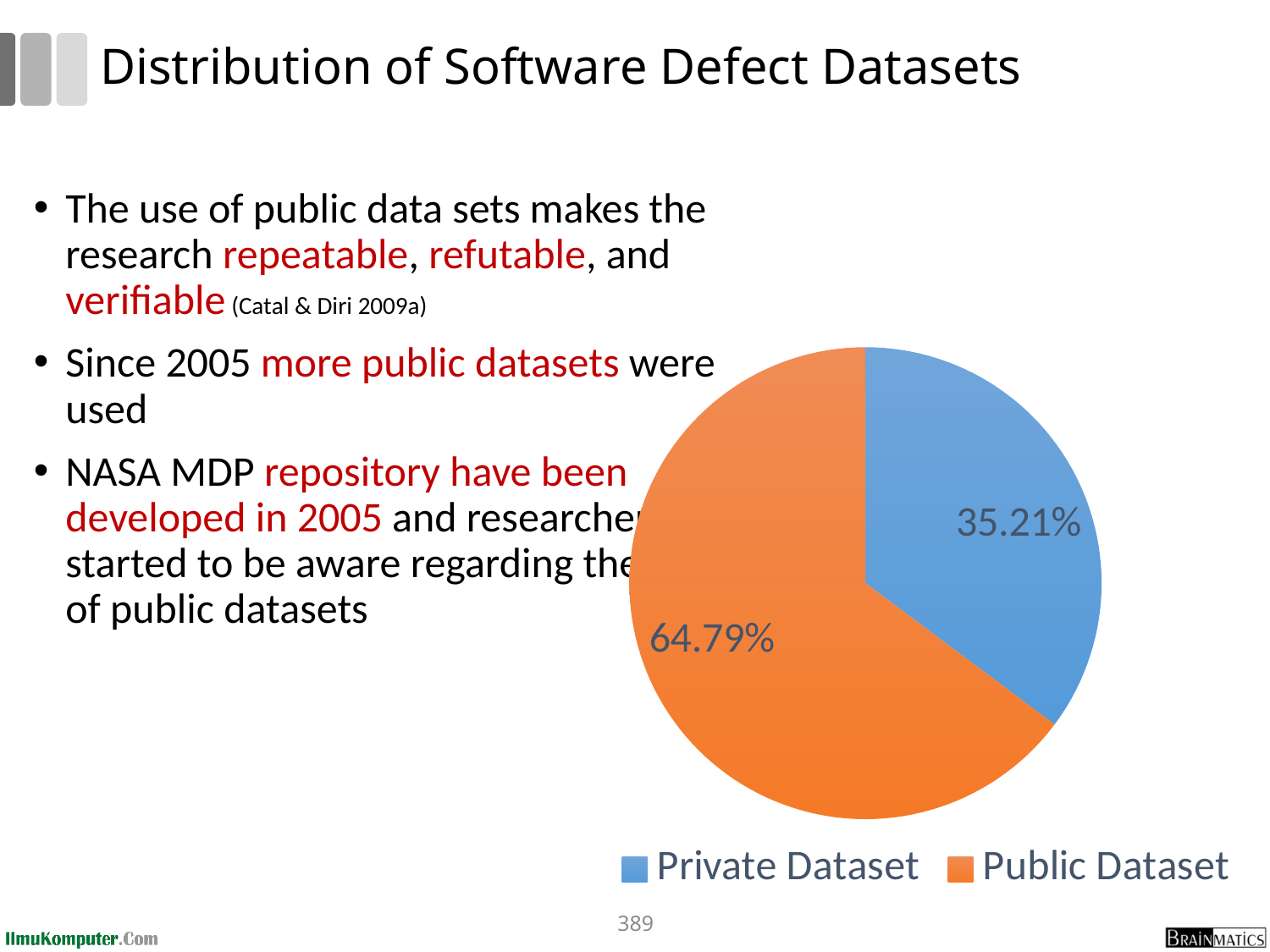
What colour is the Private Dataset slice? blue Which category has the largest share of the pie? Public Dataset What kind of chart is shown on the slide? pie chart How many slices does the pie chart have? 2 Which is larger, the share for Private Dataset or the share for Public Dataset? Public Dataset How many entries does the legend list? 2 What share of the pie does Public Dataset have? 64.79% What colour is the Public Dataset slice? orange Which category has the smallest share of the pie? Private Dataset What is the difference in percentage points between the Public Dataset share and the Private Dataset share? 29.58 What share of the pie does Private Dataset have? 35.21%